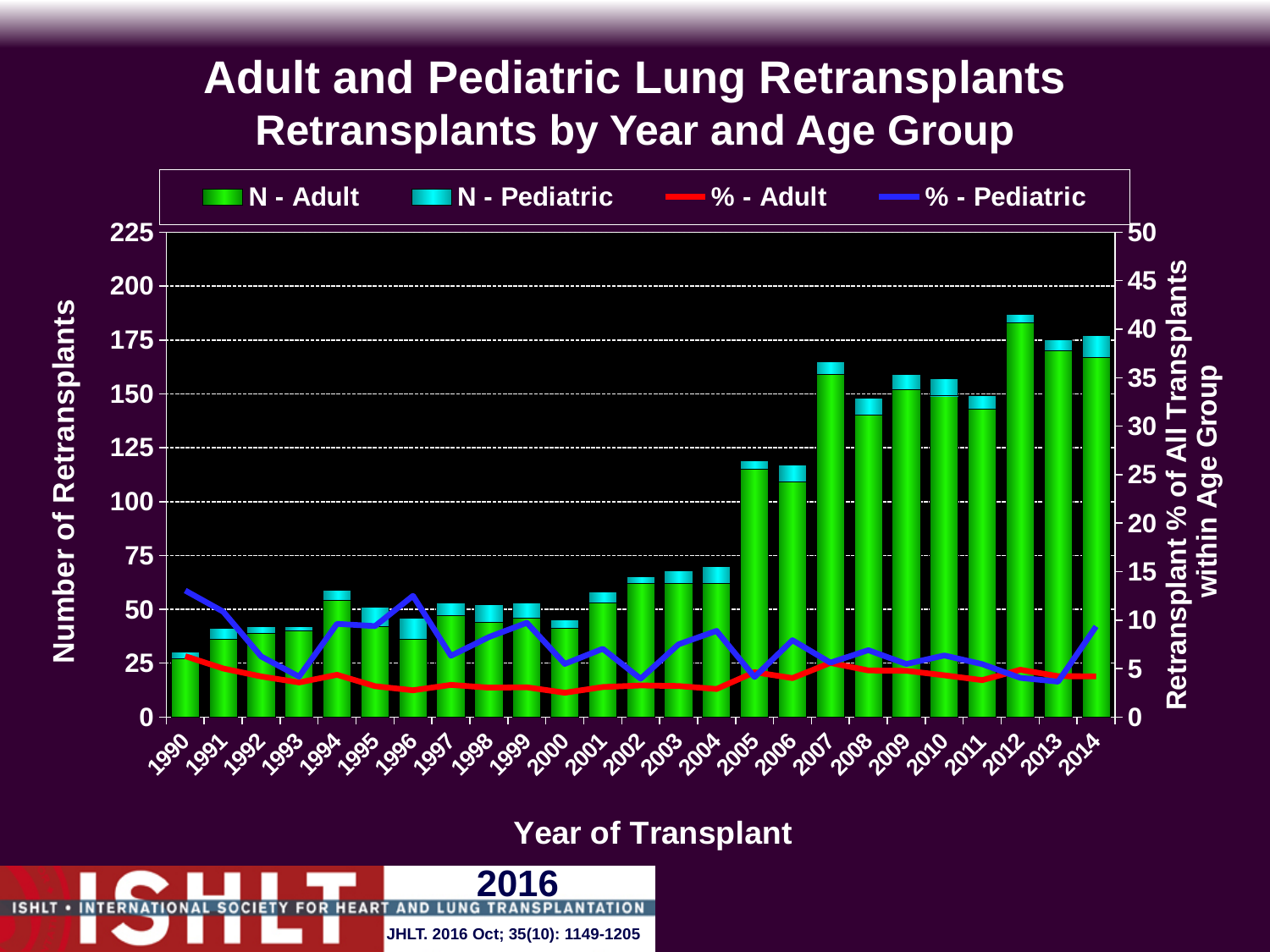
What kind of chart is shown on the slide? bar chart with overlaid line series Do the stacked bars generally rise or fall from 1990 to 2014? rise Is the total number of retransplants in 2005 greater or less than 100? greater Is the % - Adult value in 2000 greater or less than 5? less Which year has the shortest stacked bar for number of retransplants? 1990 Is the total number of retransplants in 2012 greater or less than 175? greater Which year has the tallest stacked bar for number of retransplants? 2012 Which year has the taller stacked bar, 2007 or 2008? 2007 What is the title of the left vertical axis? Number of Retransplants How many years are shown along the x axis? 25 How many series does the legend list? 4